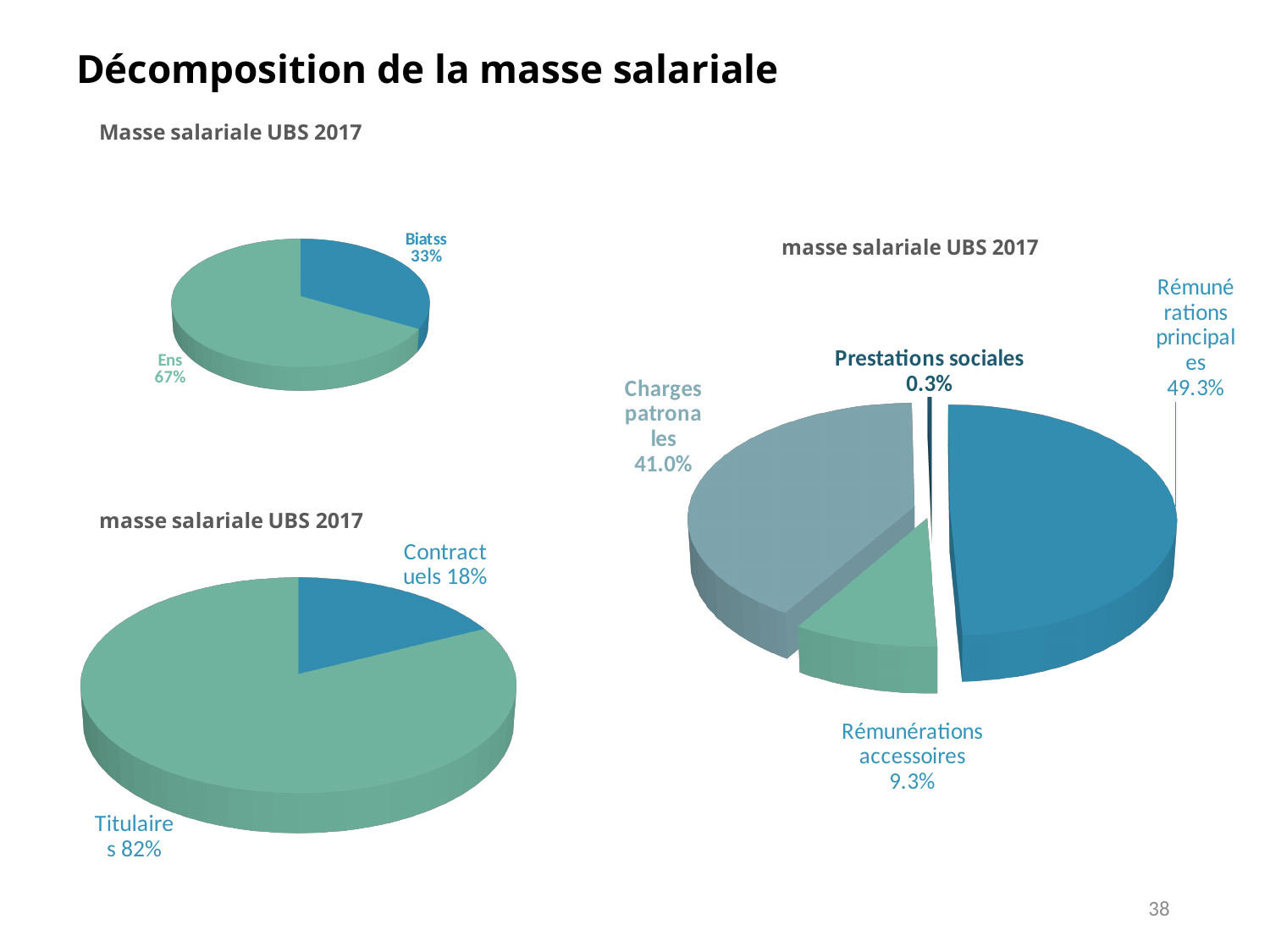
In the pie chart on the right, which is larger: Rémunérations accessoires or Charges patronales? Charges patronales In the top-left pie chart, which slice is the largest? Ens In the pie chart on the right, what share do Rémunérations principales have? 49.3% In the pie chart on the right, which slice is the smallest? Prestations sociales What type of chart is the bottom-left chart? Pie chart In the bottom-left pie chart, what share do Titulaires have? 82% In the top-left pie chart, what share does Ens have? 67% In the pie chart on the right, how many slices are there? 4 In the bottom-left pie chart, what is the difference between the Titulaires and Contractuels shares? 64%